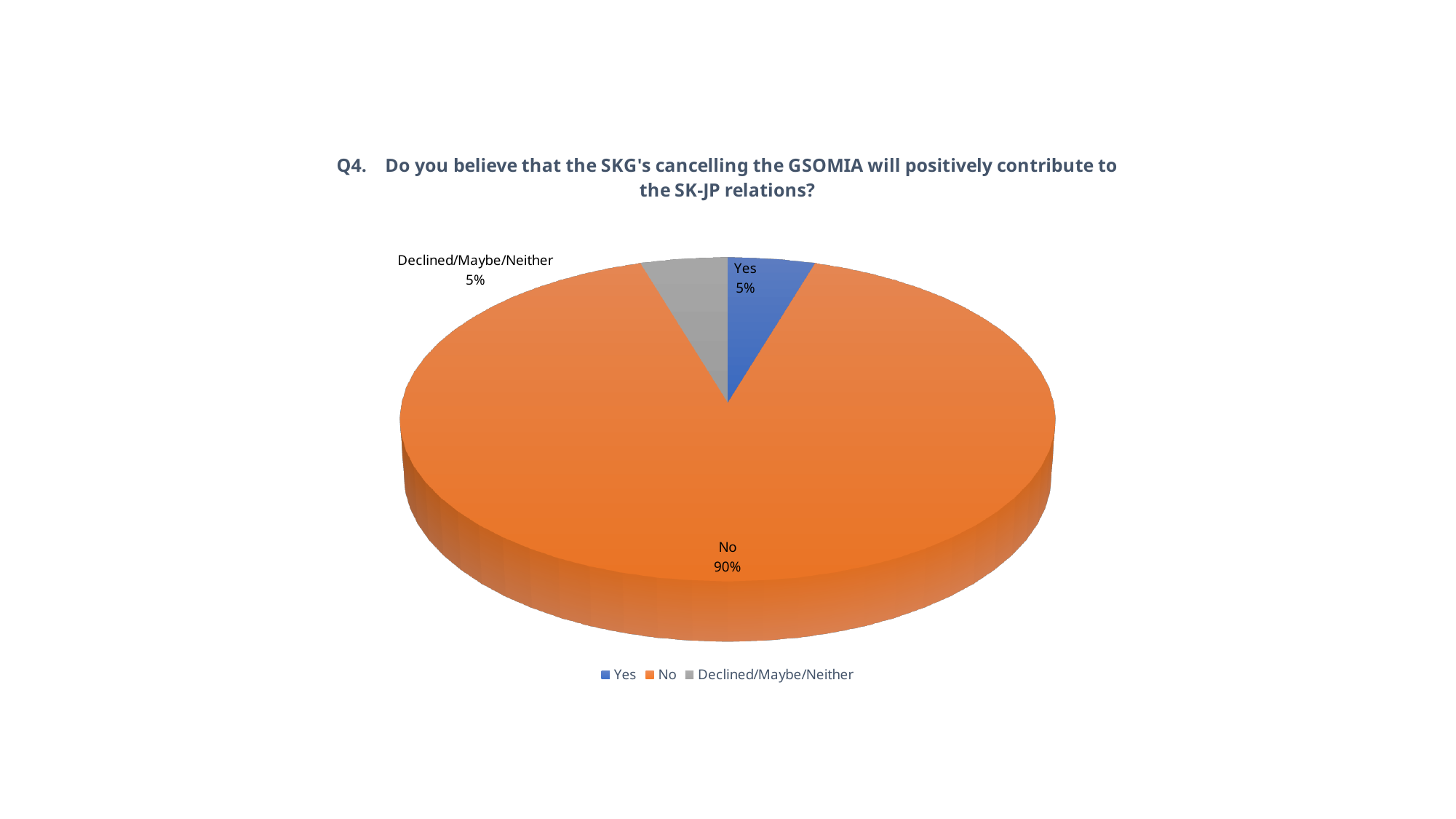
What share of respondents answered "Yes"? 5% What share of respondents are in the "Declined/Maybe/Neither" category? 5% How many entries does the legend list? 3 Which response has the largest share of the pie? No What is the combined share of "Yes" and "Declined/Maybe/Neither"? 10% What share of respondents answered "No"? 90% What colour is the "No" slice? Orange Which is larger, the share for "No" or the share for "Declined/Maybe/Neither"? No What colour is the "Yes" slice? Blue What kind of chart is shown on the slide? Pie chart How many slices does the pie chart have? 3 What is the difference in percentage points between the "No" and "Yes" shares? 85